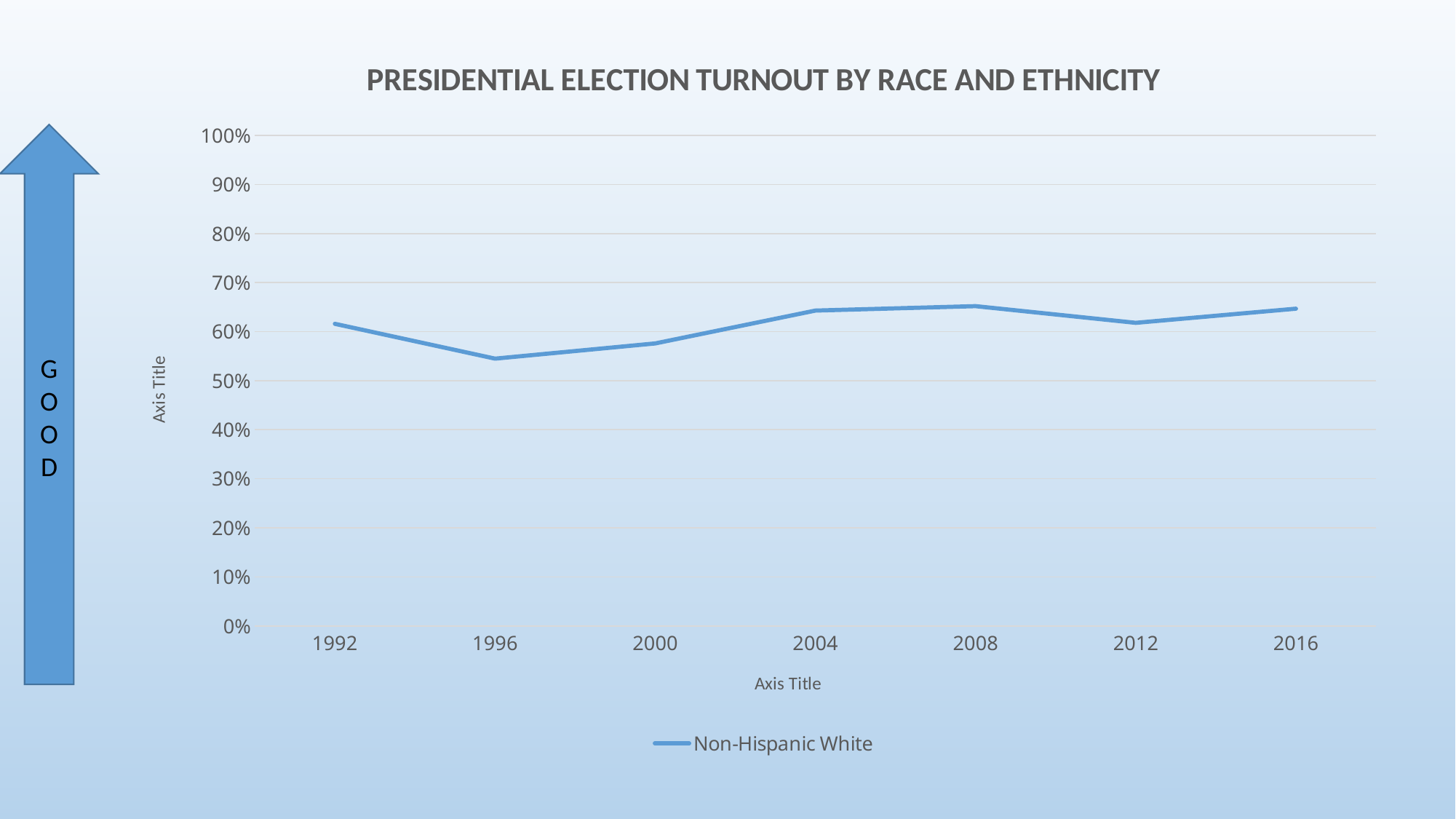
How many years are plotted along the x axis? 7 What kind of chart is shown on the slide? line chart Is the value for 2000 greater or less than 60%? less How many series does the legend list? 1 Which is larger, the value for 1996 or the value for 2004? 2004 What is the title of the chart? PRESIDENTIAL ELECTION TURNOUT BY RACE AND ETHNICITY Does the turnout rise or fall from 1992 to 1996? fall Which year has the lowest turnout for Non-Hispanic White? 1996 Is the value for 2008 greater or less than 60%? greater What series name is shown in the legend? Non-Hispanic White Is the value for 1996 greater or less than 60%? less